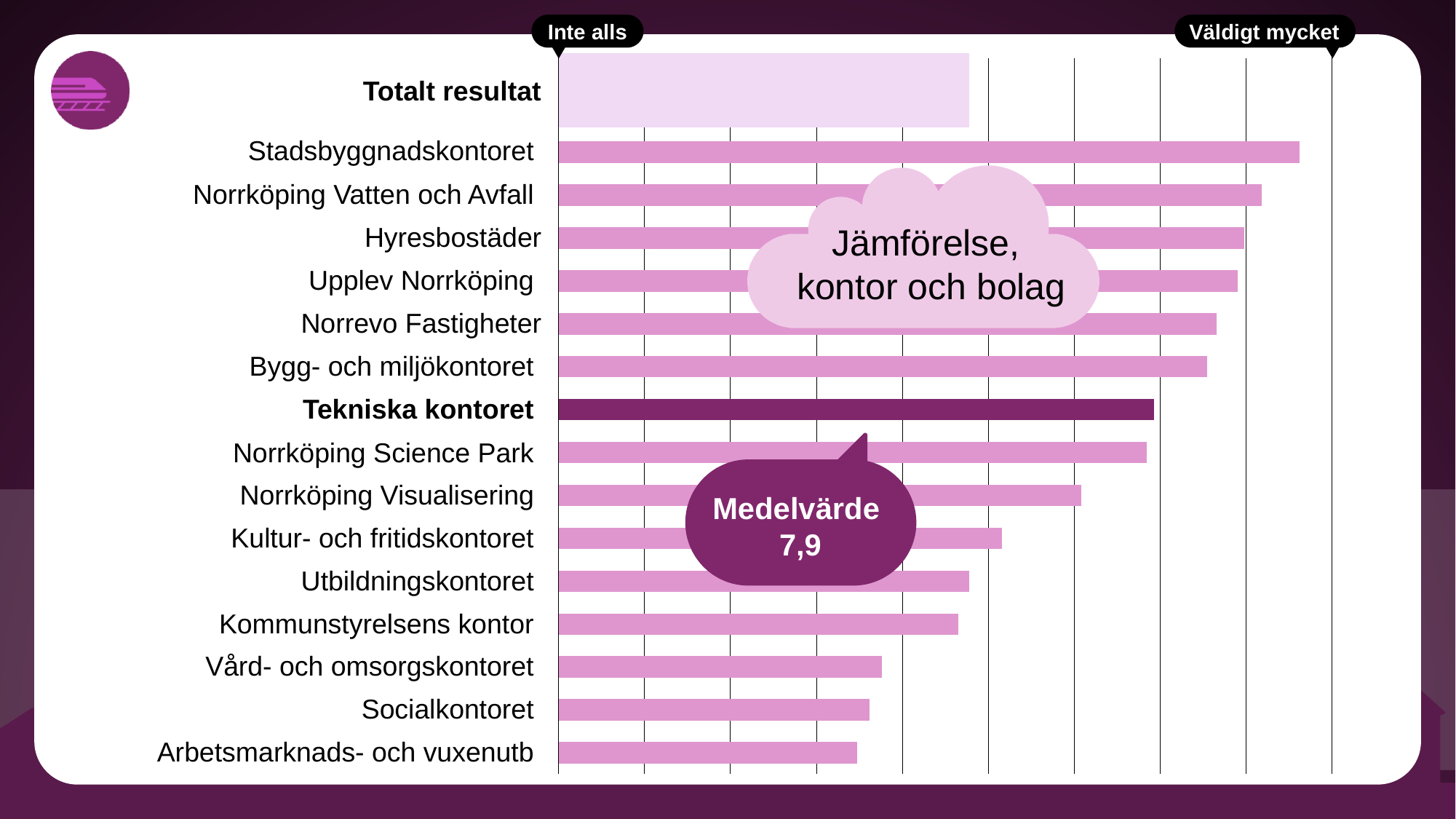
What kind of chart is shown on the slide? bar chart How many organisations are listed below 'Totalt resultat' in the chart? 15 Do the bar lengths increase or decrease going from the top organisation to the bottom one? decrease Which has the longer bar, Hyresbostäder or Socialkontoret? Hyresbostäder Which has the longer bar, Tekniska kontoret or Utbildningskontoret? Tekniska kontoret Which has the longer bar, Kultur- och fritidskontoret or Norrköping Vatten och Avfall? Norrköping Vatten och Avfall Which bar is drawn in a darker colour than the others? Tekniska kontoret Which category has the longest bar? Stadsbyggnadskontoret What is the title shown in the cloud on the chart? Jämförelse, kontor och bolag What mean value (Medelvärde) is shown in the callout pointing to the Tekniska kontoret bar? 7,9